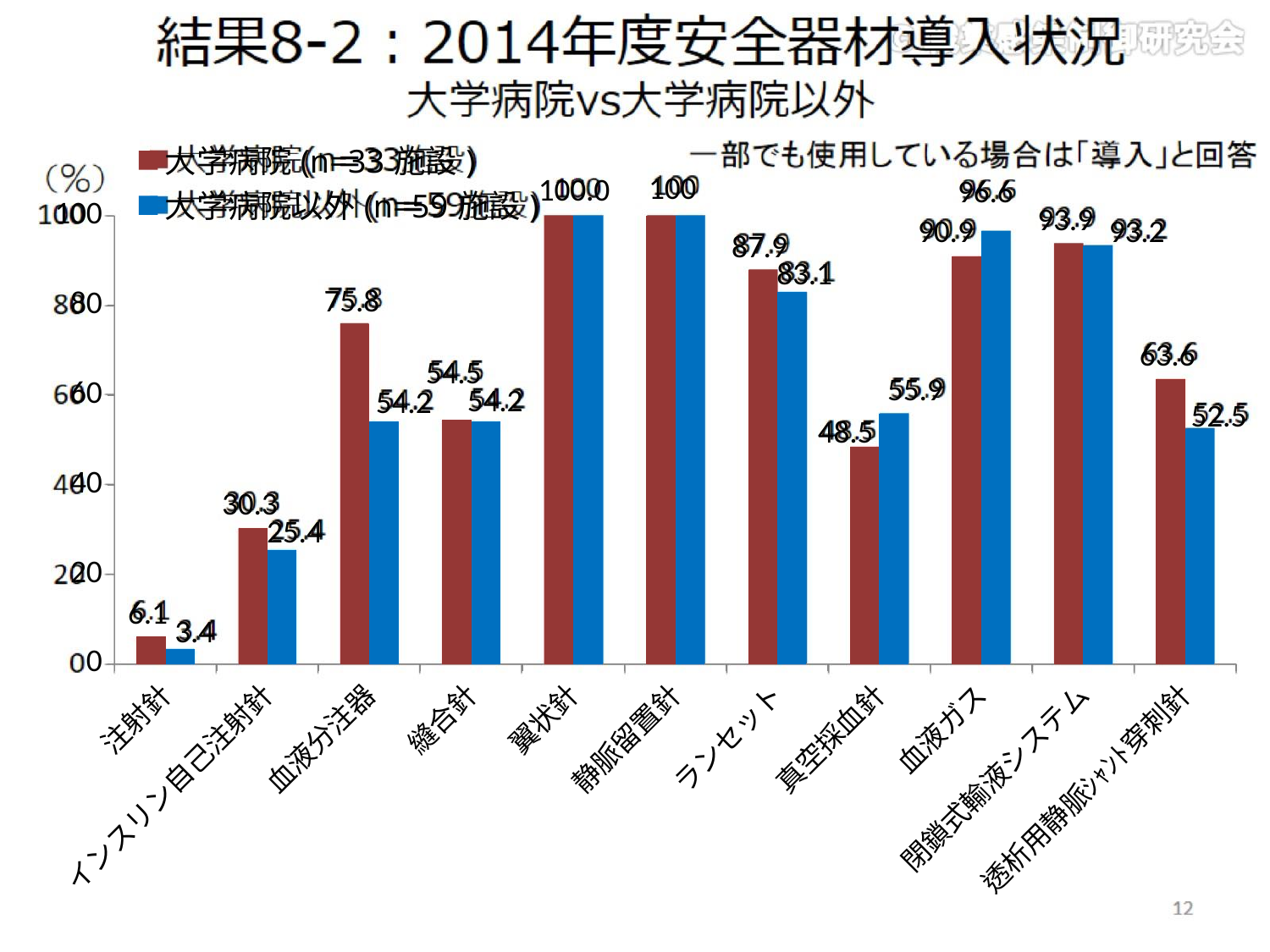
What is the difference between the 大学病院以外 and 大学病院 values for 血液ガス? 5.7 What kind of chart is shown on the slide? bar chart For 真空採血針, which series has the larger value, 大学病院 or 大学病院以外? 大学病院以外 What is the value for 大学病院以外 for 透析用静脈シャント穿刺針? 52.5 How many series does the legend list? 2 What is the difference between the 大学病院 and 大学病院以外 values for 血液分注器? 21.6 Is the value for 大学病院 for ランセット greater or less than 80? greater How many categories are shown on the x axis? 11 What is the value for 大学病院 for インスリン自己注射針? 30.3 What is the value for 大学病院以外 for 真空採血針? 55.9 Which category has the lowest value for 大学病院以外? 注射針 What is the value for 大学病院 for 血液分注器? 75.8